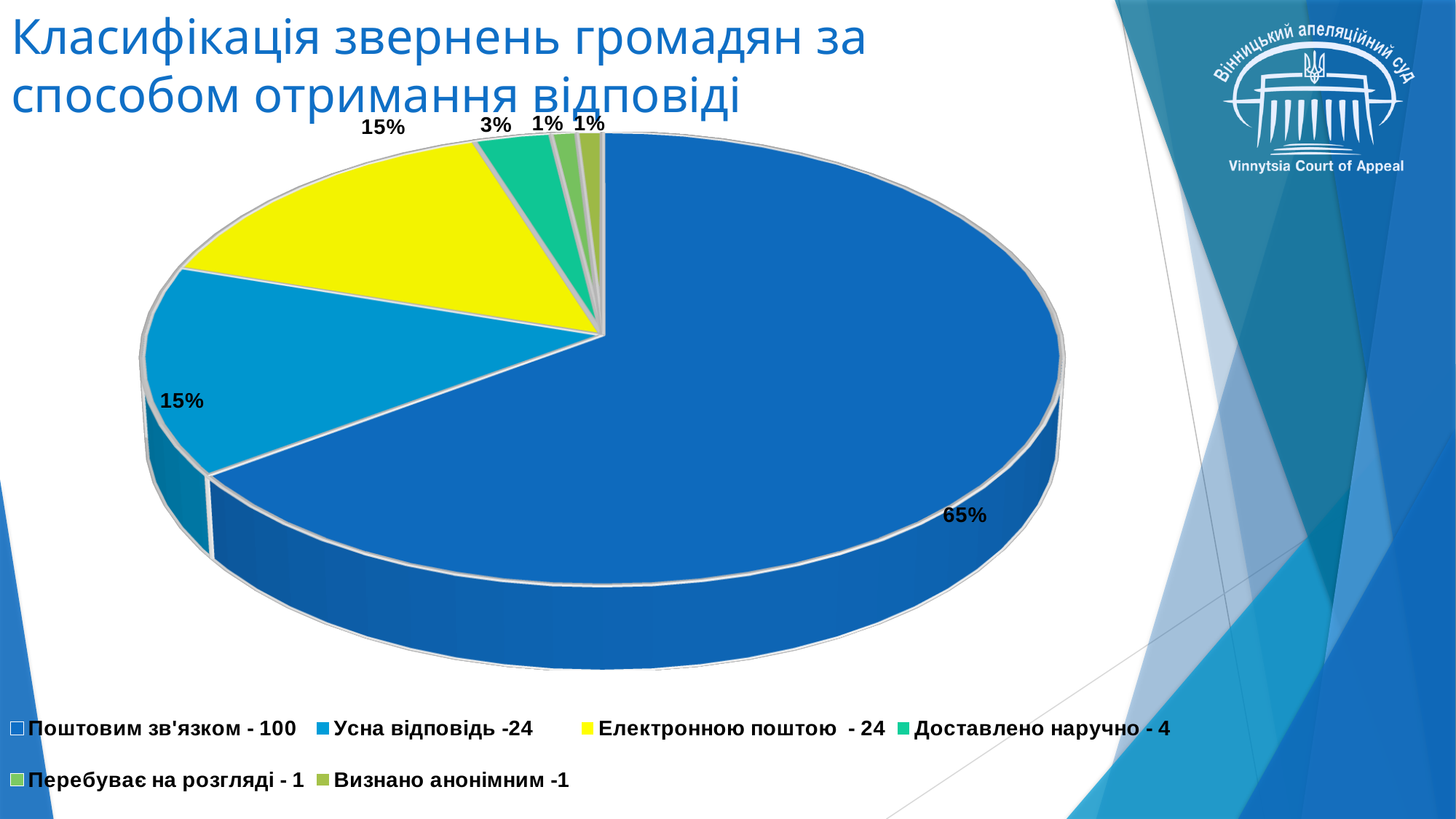
What is the title of the slide containing the pie chart? Класифікація звернень громадян за способом отримання відповіді What percentage is shown for the "Електронною поштою - 24" slice? 15% What share of the pie does the slice for "Поштовим зв'язком - 100" represent? 65% Which category has the largest slice of the pie? Поштовим зв'язком - 100 How many entries does the legend list? 6 What is the difference in percentage points between the "Поштовим зв'язком - 100" slice and the "Усна відповідь -24" slice? 50% What type of chart is shown on the slide? pie chart How many slices does the pie chart have? 6 Which is larger: the slice for "Усна відповідь -24" or the slice for "Доставлено наручно - 4"? Усна відповідь -24 What colour is the slice for "Електронною поштою - 24"? yellow What percentage is shown for the "Перебуває на розгляді - 1" slice? 1%